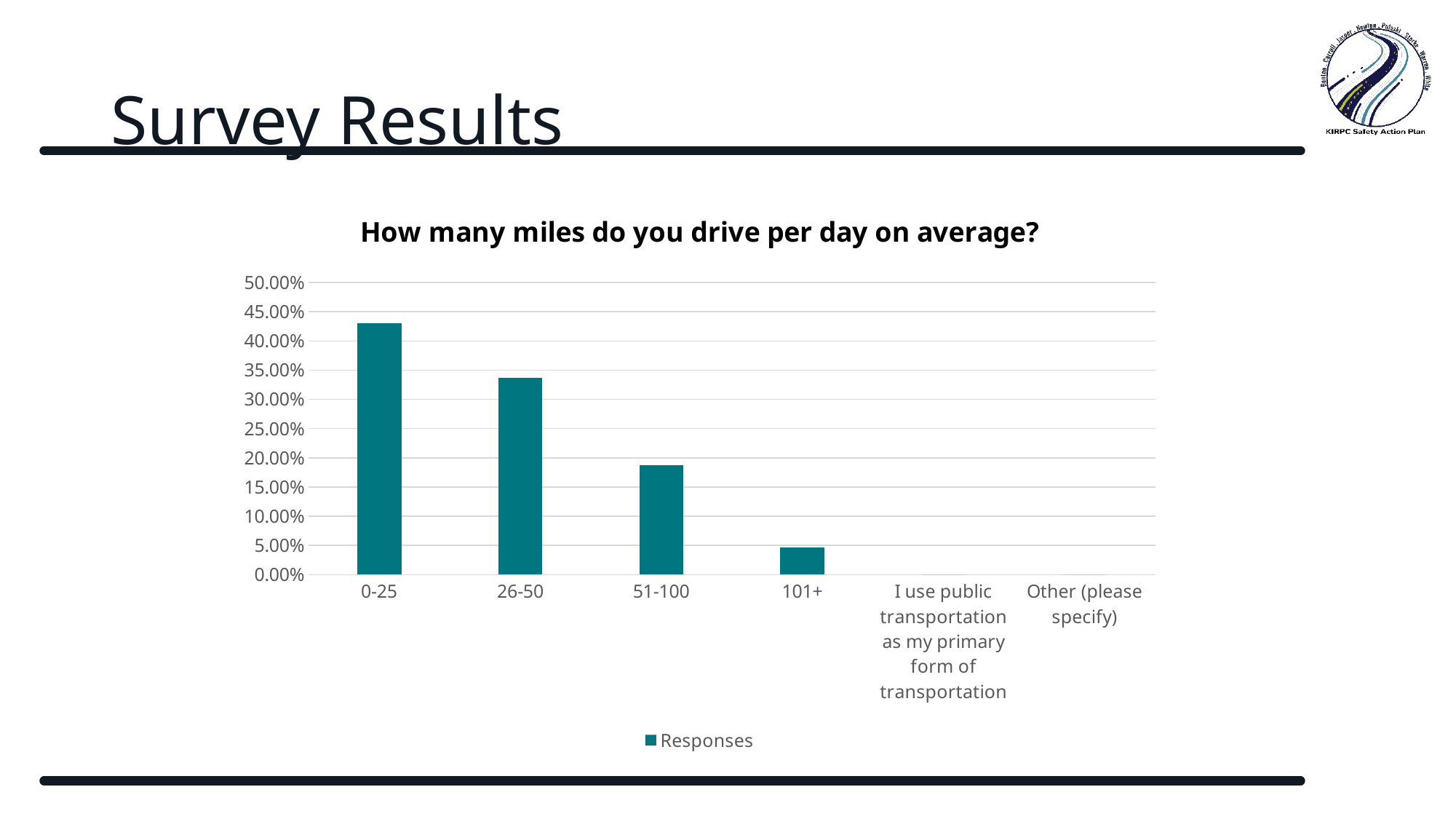
Is the value for 26-50 greater or less than 35.00%? less What type of chart is shown on the slide? Bar chart How many categories are shown on the x axis? 6 Which category has the highest value? 0-25 How many series does the legend list? 1 Among the four mileage ranges (0-25, 26-50, 51-100, 101+), which has the lowest value? 101+ Which is larger, the value for 26-50 or the value for 51-100? 26-50 What is the title of the chart? How many miles do you drive per day on average? What is the name of the series shown in the legend? Responses Is the value for 51-100 greater or less than 15.00%? greater Is the value for 0-25 greater or less than 40.00%? greater